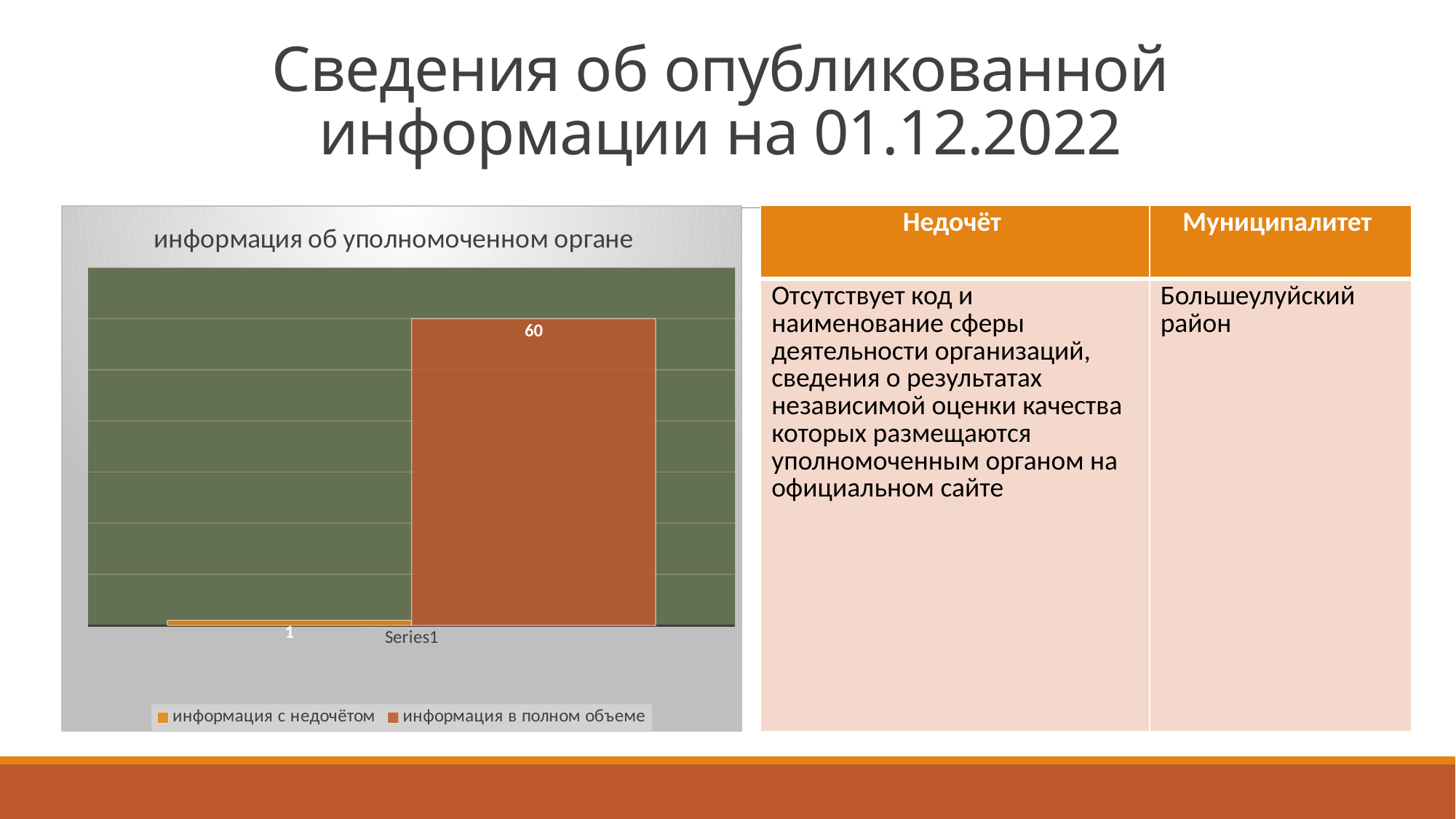
What kind of chart is shown on the slide? bar chart What is the total of the two values shown in the chart? 61 What is the title of the chart? информация об уполномоченном органе What is the value for 'информация с недочётом' in the chart? 1 What is the value for 'информация в полном объеме' in the chart? 60 Which series has the lower value in the chart? информация с недочётом Is the value for 'информация в полном объеме' larger or smaller than the value for 'информация с недочётом'? larger What is the difference between 'информация в полном объеме' and 'информация с недочётом'? 59 Which series has the higher value in the chart? информация в полном объеме What is the category label shown on the x axis of the chart? Series1 How many series does the legend list? 2